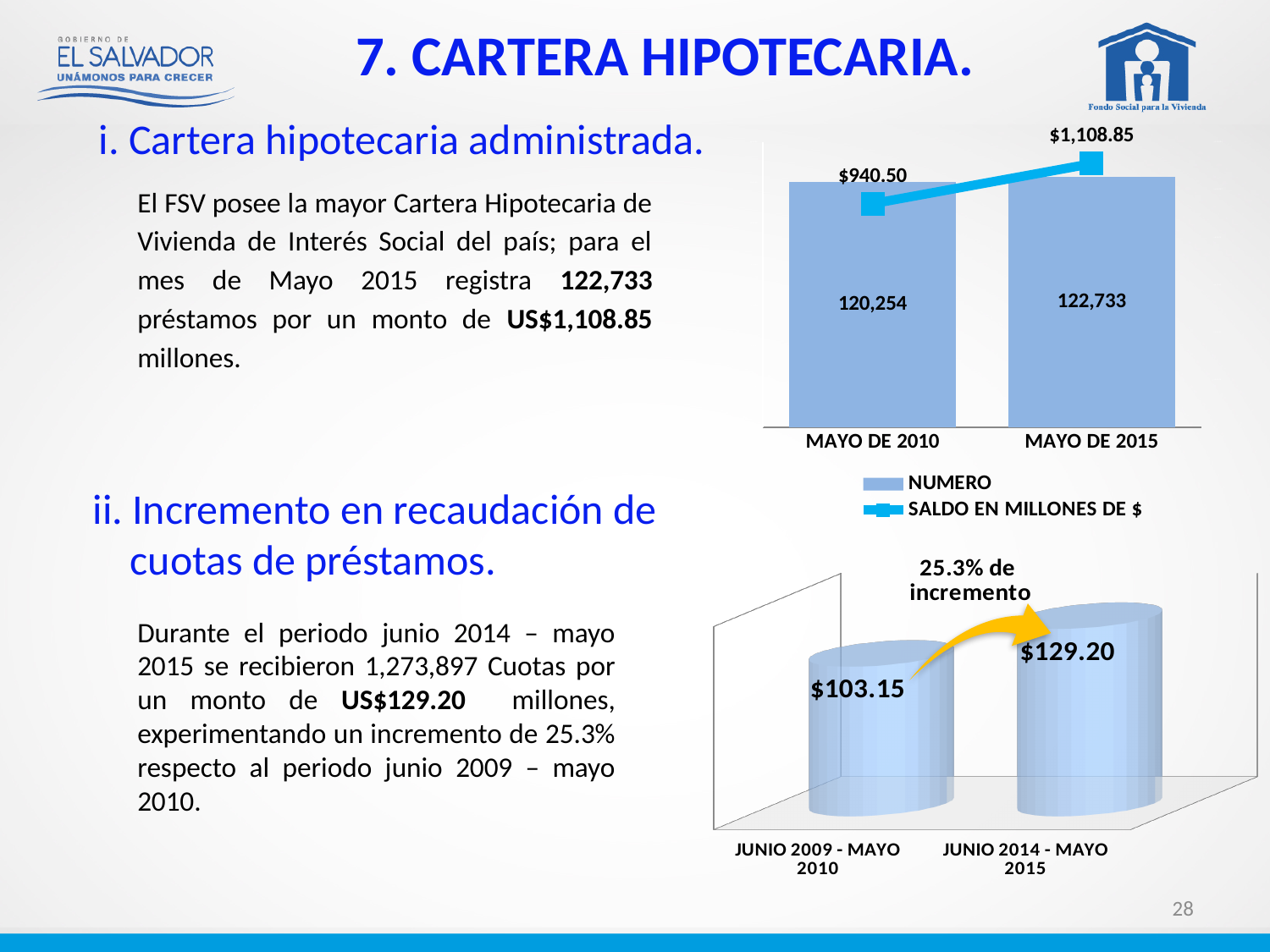
In the bottom-right chart, how many categories are shown? 2 In the top-right chart, what is the NUMERO value for MAYO DE 2010? 120,254 In the top-right chart, what is the NUMERO value for MAYO DE 2015? 122,733 In the bottom-right chart, what is the value for JUNIO 2014 - MAYO 2015? $129.20 In the top-right chart, what is the difference in NUMERO between MAYO DE 2015 and MAYO DE 2010? 2,479 In the top-right chart, which series is shown as a line? SALDO EN MILLONES DE $ In the top-right chart, what is the SALDO EN MILLONES DE $ value for MAYO DE 2015? $1,108.85 In the top-right chart, how many series does the legend list? 2 In the bottom-right chart, which period has the higher value? JUNIO 2014 - MAYO 2015 In the top-right chart, does the SALDO EN MILLONES DE $ series rise or fall from MAYO DE 2010 to MAYO DE 2015? rise In the bottom-right chart, what is the value for JUNIO 2009 - MAYO 2010? $103.15 In the top-right chart, what is the SALDO EN MILLONES DE $ value for MAYO DE 2010? $940.50